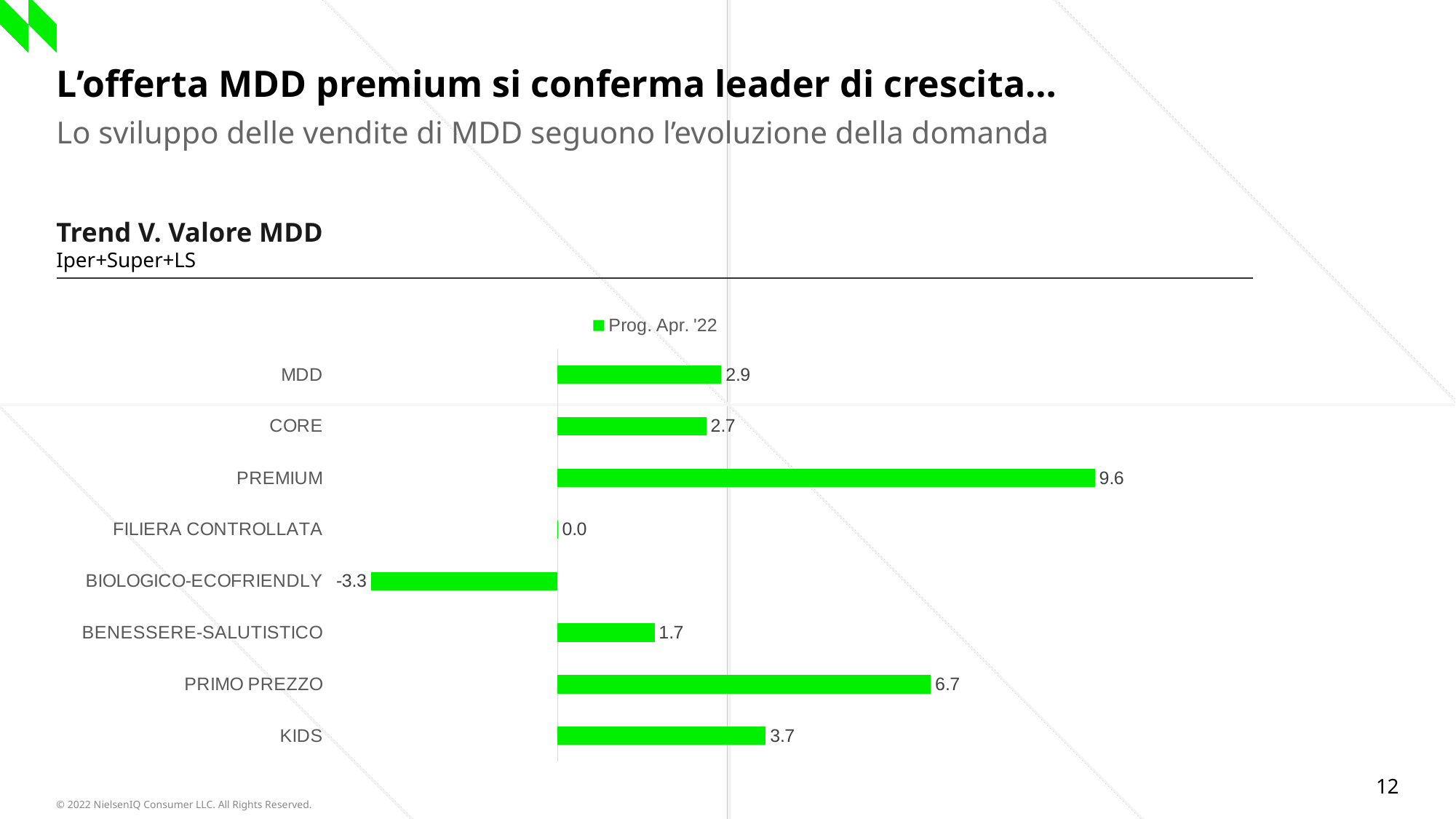
What kind of chart is shown on the slide? Bar chart What is the value for BIOLOGICO-ECOFRIENDLY? -3.3 What is the value for PREMIUM? 9.6 Which category has the highest value? PREMIUM Which category has the lowest value? BIOLOGICO-ECOFRIENDLY What is the value for FILIERA CONTROLLATA? 0.0 What is the name of the series shown in the legend? Prog. Apr. '22 Which is larger, the value for CORE or the value for KIDS? KIDS What is the difference between the values for PREMIUM and PRIMO PREZZO? 2.9 How many series does the legend list? 1 What is the value for KIDS? 3.7 How many categories are shown in the chart? 8